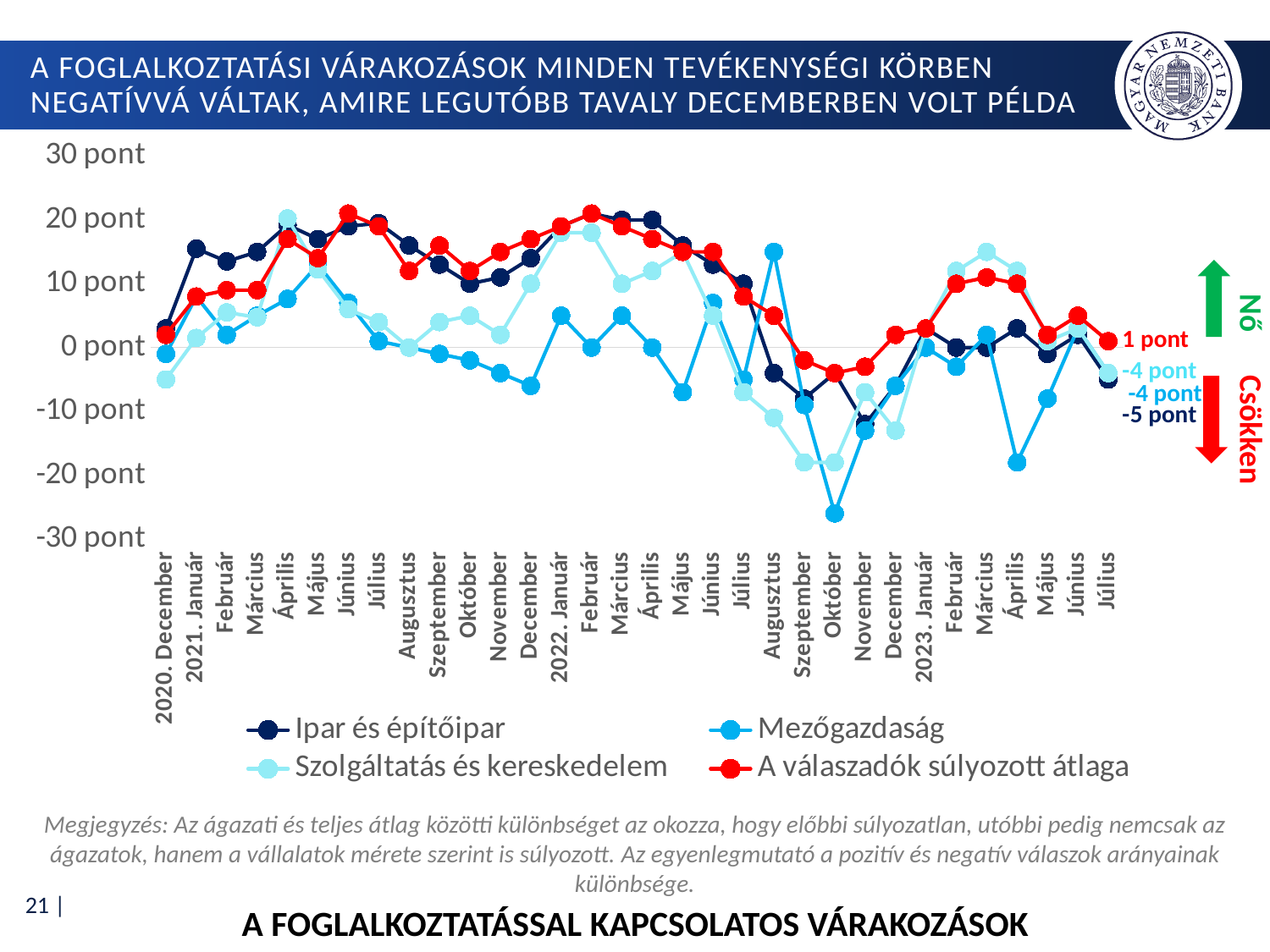
What is the value for 'Szolgáltatás és kereskedelem' in 2023 Július? -4 pont Is the value for 'Ipar és építőipar' in 2021 Január greater or less than 10 pont? greater Is the value for 'Mezőgazdaság' in 2022 Október greater or less than -20 pont? less What is the value for 'Ipar és építőipar' in 2023 Július? -5 pont Which series has the lowest value in 2022 Október? Mezőgazdaság Does the value for 'A válaszadók súlyozott átlaga' rise or fall from 2023 Március to 2023 Július? fall How many series does the legend list? 4 What is the value for 'Mezőgazdaság' in 2023 Július? -4 pont In 2023 Július, which is higher: 'A válaszadók súlyozott átlaga' or 'Ipar és építőipar'? A válaszadók súlyozott átlaga What kind of chart is shown on the slide? line chart What is the value for 'A válaszadók súlyozott átlaga' in 2023 Július? 1 pont What is the difference between 'A válaszadók súlyozott átlaga' and 'Ipar és építőipar' in 2023 Július? 6 pont